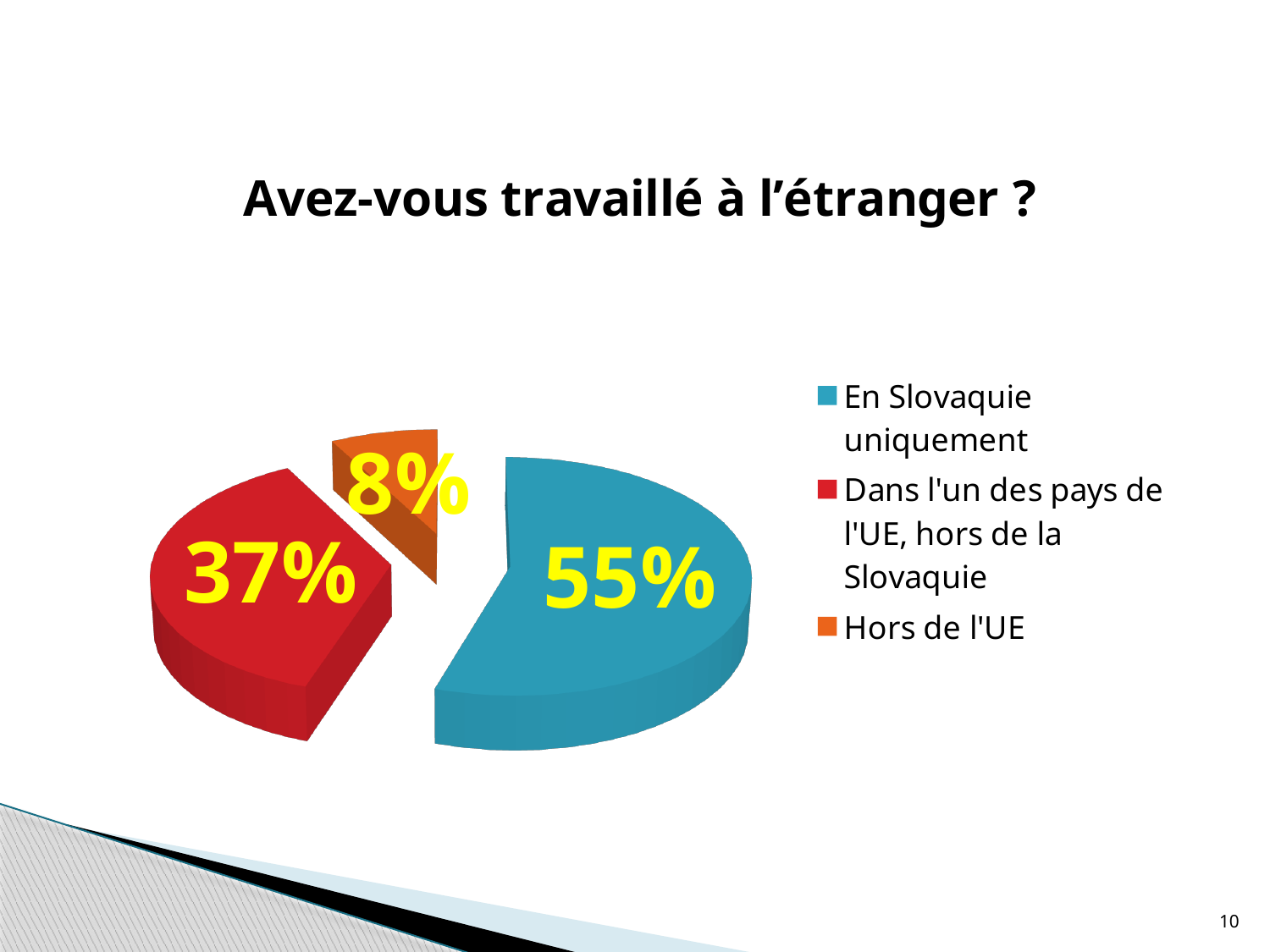
How many slices does the pie chart have? 3 What share of the pie is labelled "Hors de l'UE"? 8% How many entries does the legend list? 3 What share of the pie is labelled "En Slovaquie uniquement"? 55% Which category has the largest slice of the pie? En Slovaquie uniquement What colour is the slice for "Hors de l'UE"? Orange Which is larger: the "Dans l'un des pays de l'UE, hors de la Slovaquie" slice or the "Hors de l'UE" slice? Dans l'un des pays de l'UE, hors de la Slovaquie What is the title of the chart? Avez-vous travaillé à l'étranger ? What share of the pie is labelled "Dans l'un des pays de l'UE, hors de la Slovaquie"? 37% What kind of chart is shown on the slide? Pie chart What is the difference in percentage points between the "En Slovaquie uniquement" slice and the "Dans l'un des pays de l'UE, hors de la Slovaquie" slice? 18 Which category has the smallest slice of the pie? Hors de l'UE